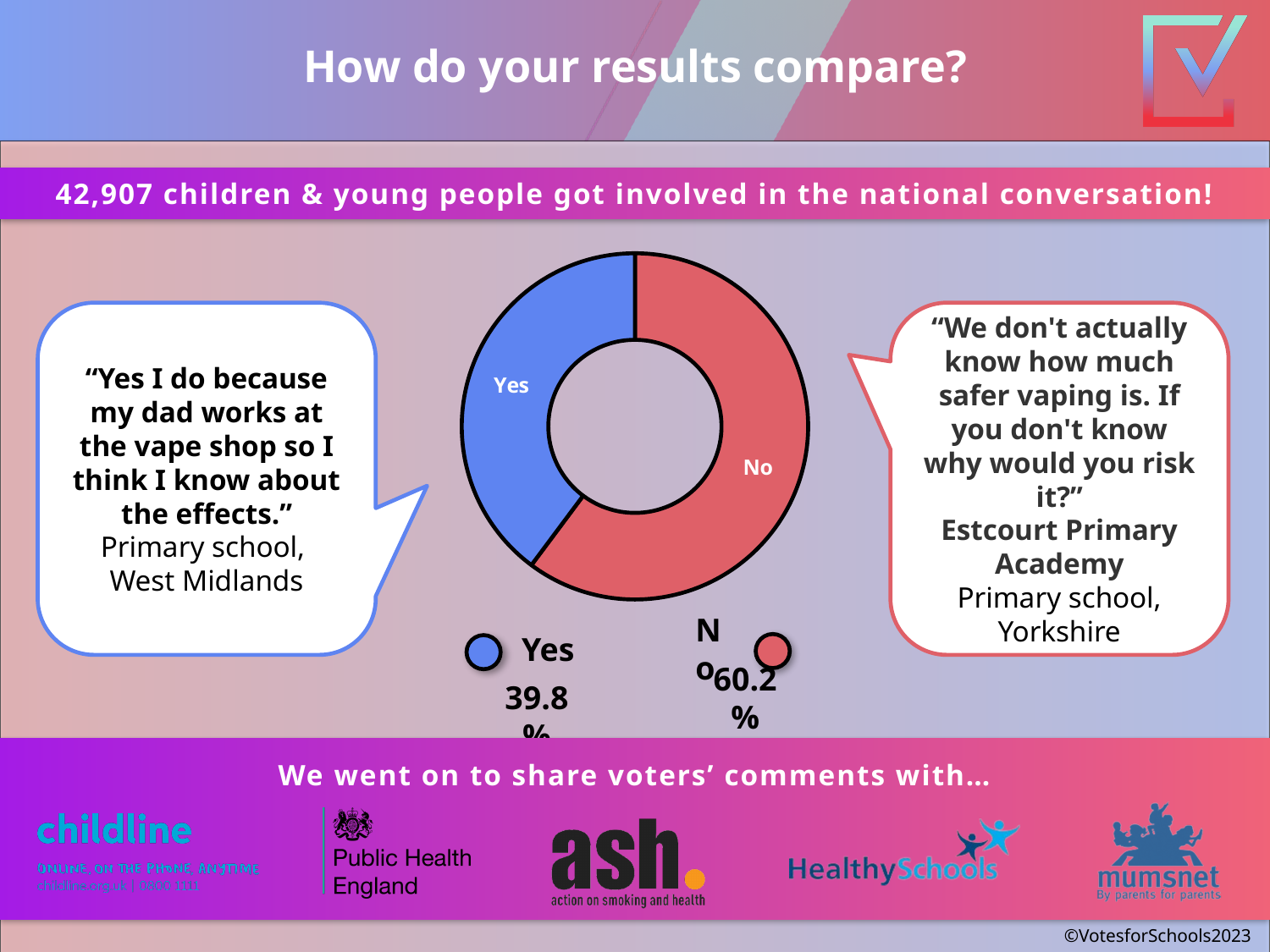
What is the difference in percentage points between the No share and the Yes share in the donut chart? 20.4% Is the share for No in the donut chart greater or less than 50%? greater Which response has the smaller share in the donut chart? Yes Is the share for Yes in the donut chart larger or smaller than the share for No? smaller How many children and young people got involved in the national conversation, according to the slide? 42,907 What kind of chart is used to show the Yes/No results on the slide? donut chart What colour represents the No segment in the donut chart? red What colour represents the Yes segment in the donut chart? blue What percentage of respondents answered No in the donut chart? 60.2% What percentage of respondents answered Yes in the donut chart? 39.8% How many categories are shown in the donut chart? 2 Which response has the larger share in the donut chart, Yes or No? No